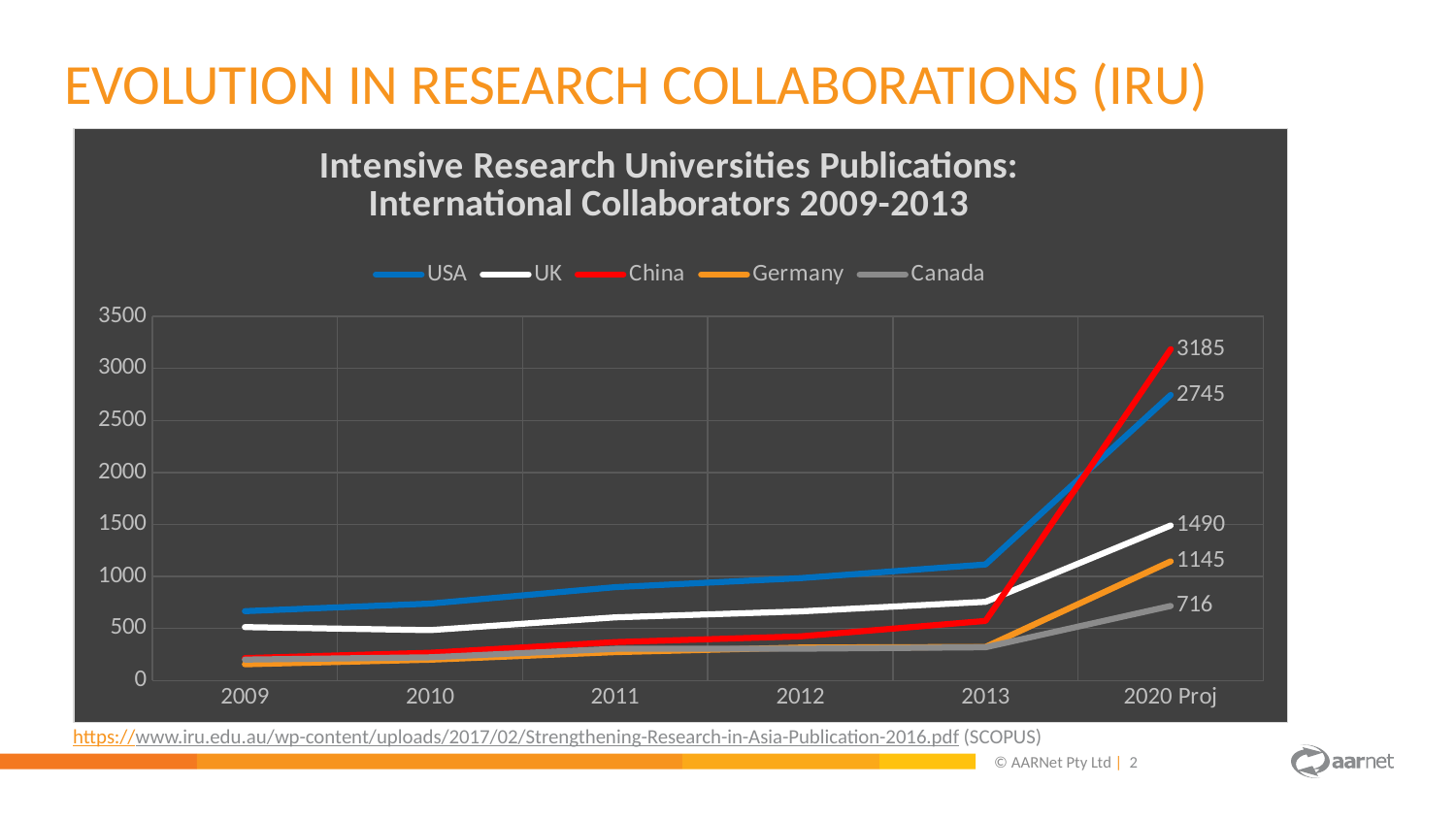
What is the projected value for China in 2020 Proj? 3185 What kind of chart is shown on the slide? line chart What is the projected value for USA in 2020 Proj? 2745 What is the difference between the China and USA values at 2020 Proj? 440 At 2020 Proj, which is larger: the value for Germany or the value for UK? UK What is the projected value for Canada in 2020 Proj? 716 How many series does the legend list? 5 Does the USA line rise or fall from 2009 to 2020 Proj? rise Is the value for USA in 2013 greater or less than 1000? greater Which series has the highest value at 2020 Proj? China What is the projected value for UK in 2020 Proj? 1490 Which series has the lowest value at 2020 Proj? Canada